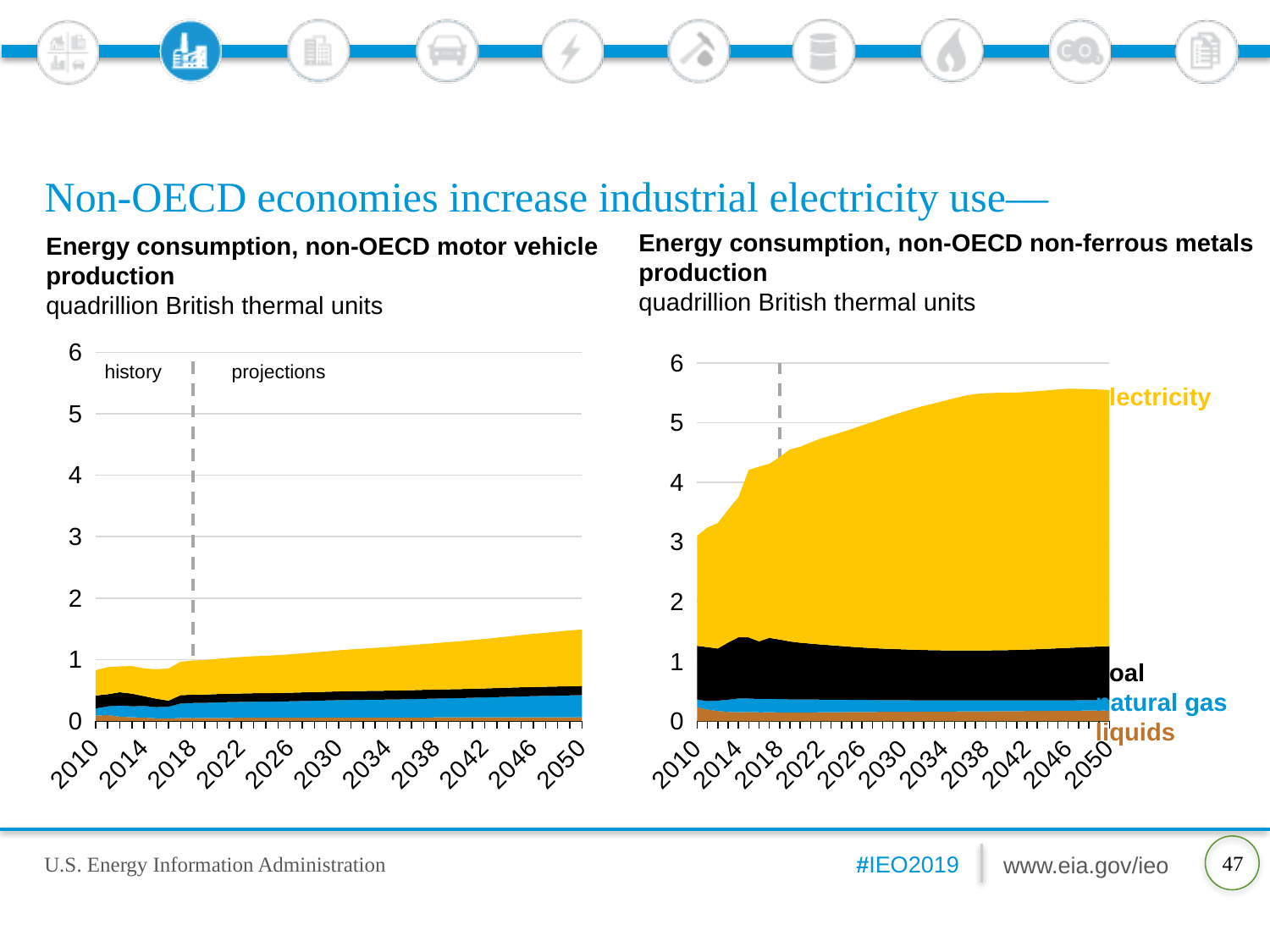
In the 'Energy consumption, non-OECD non-ferrous metals production' chart, does total energy consumption rise or fall from 2010 to 2050? rise In the 'Energy consumption, non-OECD non-ferrous metals production' chart, is the total consumption in 2010 greater or less than 4? less Which chart shows higher total energy consumption in 2050: the motor vehicle production chart or the non-ferrous metals production chart? non-ferrous metals production What unit is used on the y axis of both charts? quadrillion British thermal units In the 'Energy consumption, non-OECD motor vehicle production' chart, is the total consumption in 2010 greater or less than 1? less What kind of chart is the 'Energy consumption, non-OECD motor vehicle production' chart? stacked area chart In the 'Energy consumption, non-OECD motor vehicle production' chart, is the total consumption in 2050 greater or less than 2? less In the 'Energy consumption, non-OECD non-ferrous metals production' chart, which fuel accounts for the largest share of consumption? electricity How many year labels are shown on the x axis of the 'Energy consumption, non-OECD motor vehicle production' chart? 11